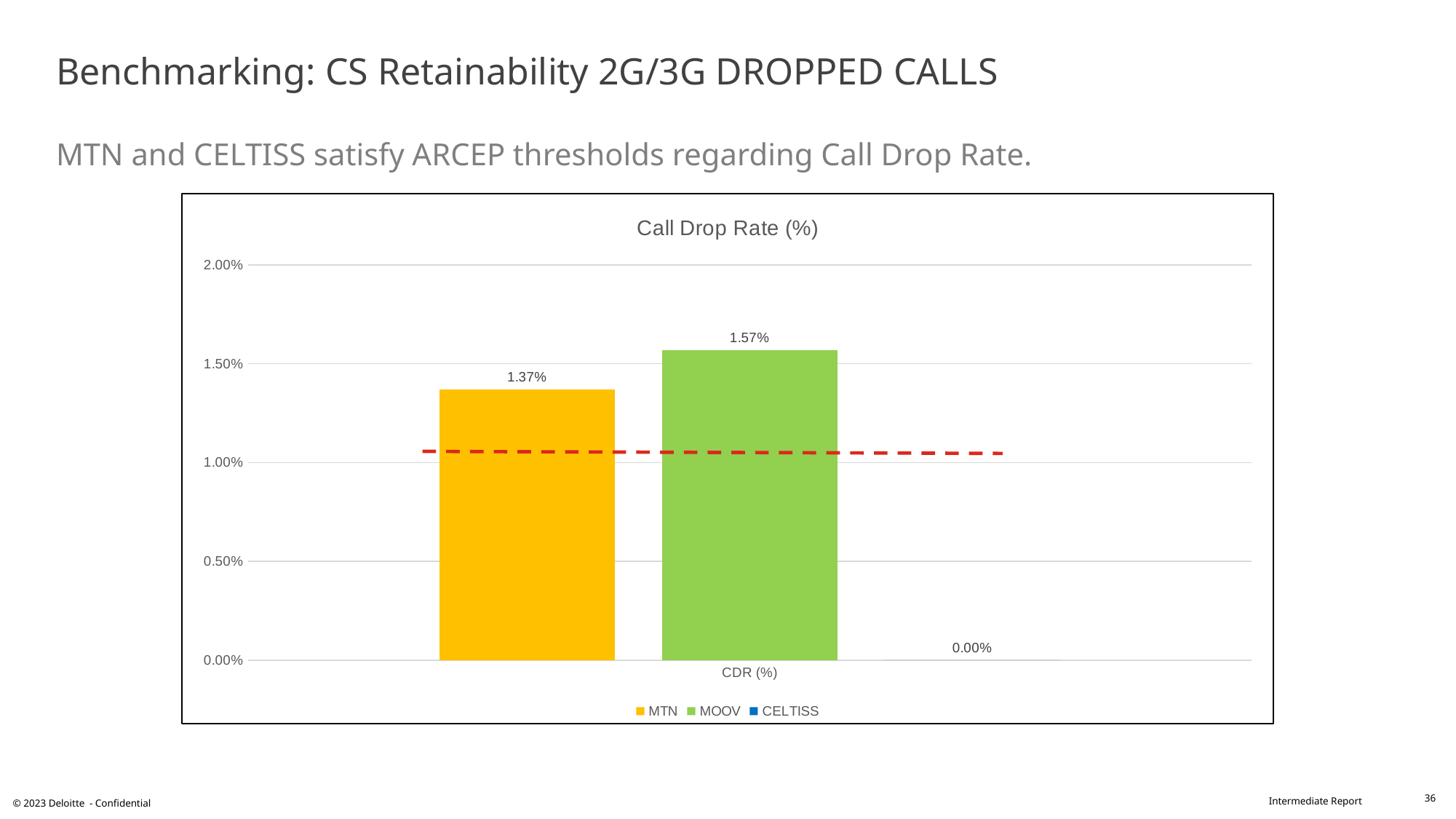
Which has a higher Call Drop Rate, MTN or MOOV? MOOV What is the Call Drop Rate value for MTN? 1.37% What is the Call Drop Rate value for CELTISS? 0.00% Which operator has the highest Call Drop Rate? MOOV How many series does the legend list? 3 What is the difference between the Call Drop Rate of MOOV and MTN? 0.20% Which operator has the lowest Call Drop Rate? CELTISS What is the title of the chart? Call Drop Rate (%) What is the Call Drop Rate value for MOOV? 1.57% What colour is the bar for MOOV? Green Is the Call Drop Rate for MTN greater or less than 1.00%? greater What kind of chart is shown on the slide? Bar chart